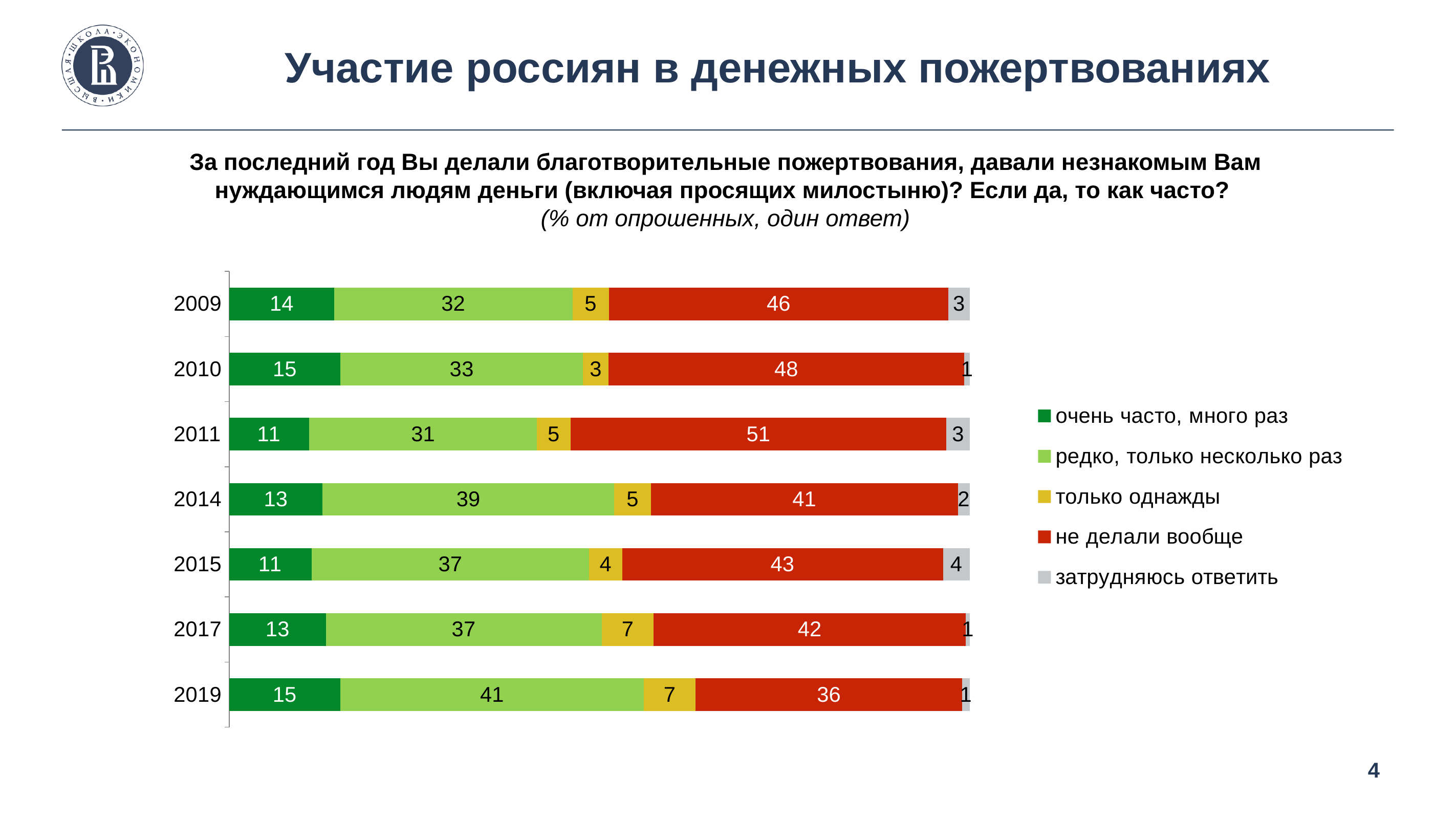
What is the value for "только однажды" in 2017? 7 What is the value for "не делали вообще" in 2011? 51 What kind of chart is shown on the slide? Stacked bar chart How many series does the legend list? 5 What is the total of the stacked bar for 2009? 100 What is the value for "затрудняюсь ответить" in 2015? 4 What is the difference between the "не делали вообще" values for 2011 and 2019? 15 In which year is the value for "не делали вообще" the highest? 2011 What is the value for "редко, только несколько раз" in 2019? 41 In which year is the value for "не делали вообще" the lowest? 2019 Which is larger: the "редко, только несколько раз" value for 2014 or for 2011? 2014 How many years are shown on the chart? 7